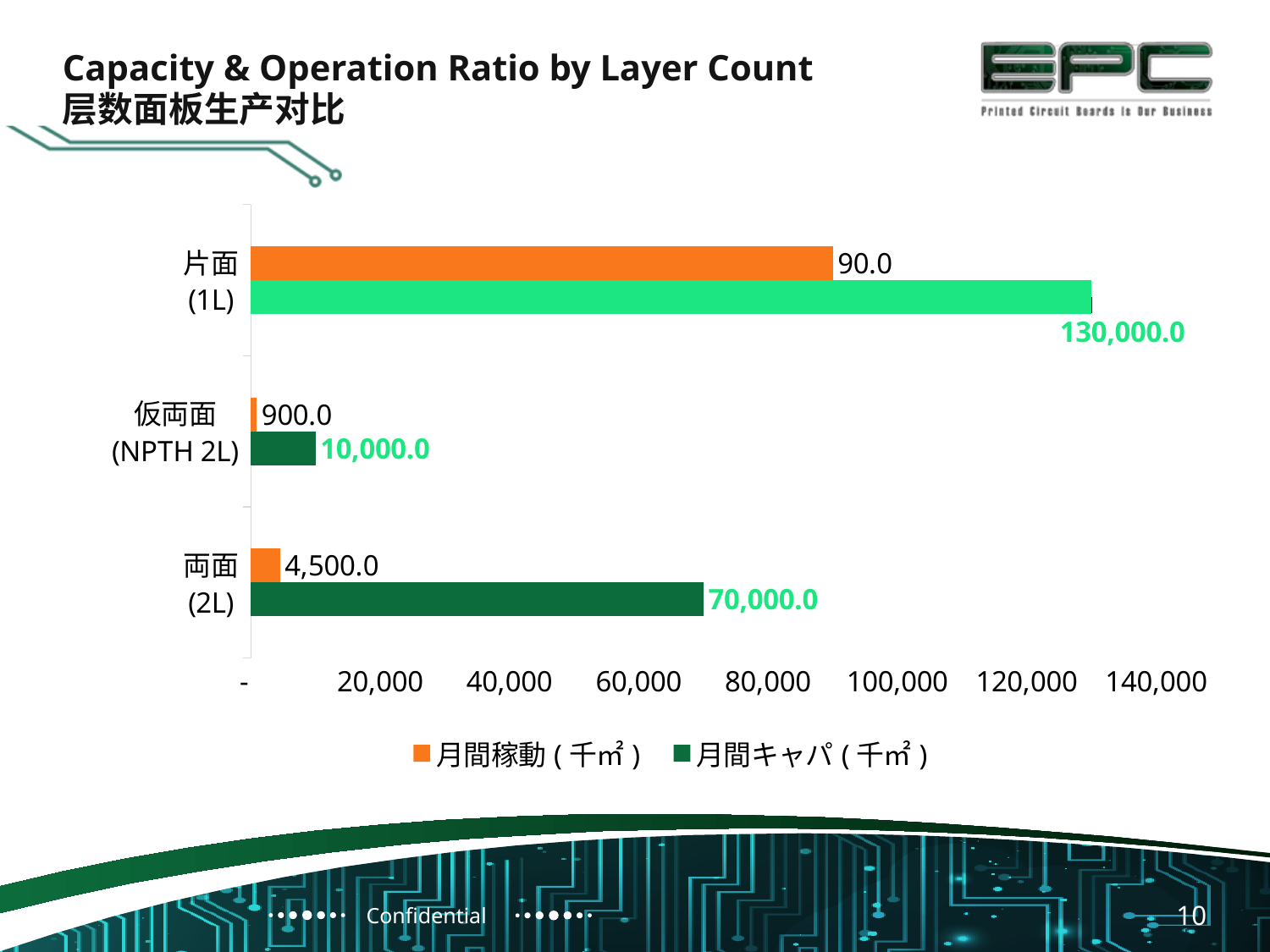
What is the 月間稼動 (千㎡) value for 両面 (2L)? 4,500.0 Which category has the highest 月間キャパ (千㎡) value? 片面 (1L) Is the 月間キャパ (千㎡) value for 両面 (2L) greater or less than 80,000? less What is the 月間キャパ (千㎡) value for 両面 (2L)? 70,000.0 How many categories are shown on the chart? 3 How many series does the legend list? 2 What is the 月間稼動 (千㎡) value for 仮両面 (NPTH 2L)? 900.0 What is the 月間キャパ (千㎡) value for 片面 (1L)? 130,000.0 What is the difference between the 月間稼動 (千㎡) values for 両面 (2L) and 仮両面 (NPTH 2L)? 3,600.0 What is the difference between the 月間キャパ (千㎡) values for 片面 (1L) and 両面 (2L)? 60,000.0 Which category has the lowest 月間キャパ (千㎡) value? 仮両面 (NPTH 2L) Which has the larger 月間キャパ (千㎡) value, 両面 (2L) or 仮両面 (NPTH 2L)? 両面 (2L)